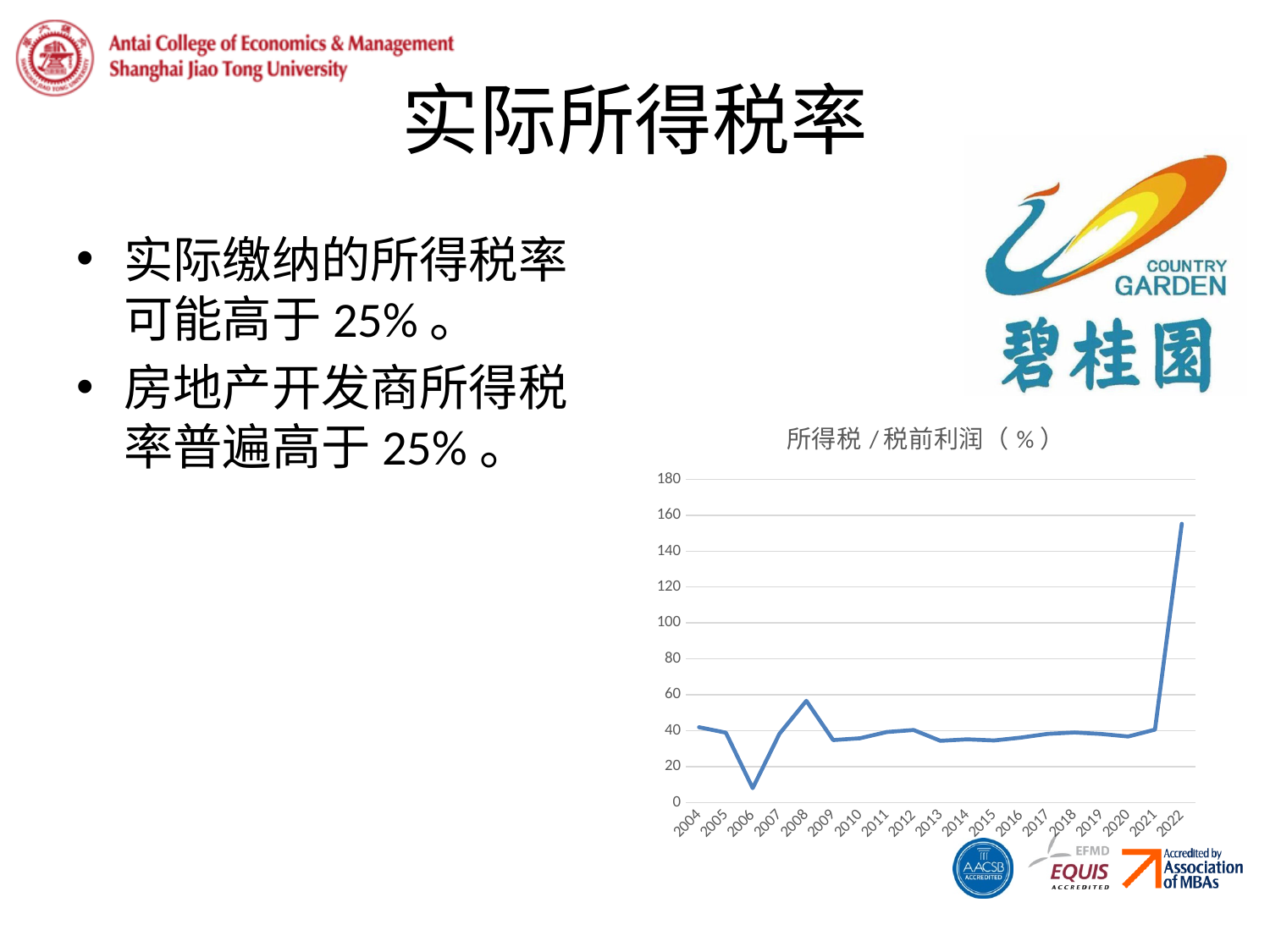
Does the value rise or fall from 2021 to 2022? rise Is the value for 2008 greater or less than 40? greater Which year has the larger value, 2004 or 2022? 2022 Which year has the lowest value in the chart? 2006 Is the value for 2006 greater or less than 20? less Is the value for 2013 greater or less than 40? less What kind of chart is shown on the slide? line chart What is the title of the chart? 所得税 / 税前利润（%） Which year has the highest value in the chart? 2022 How many years are plotted on the x axis of the chart? 19 Which year has the larger value, 2008 or 2009? 2008